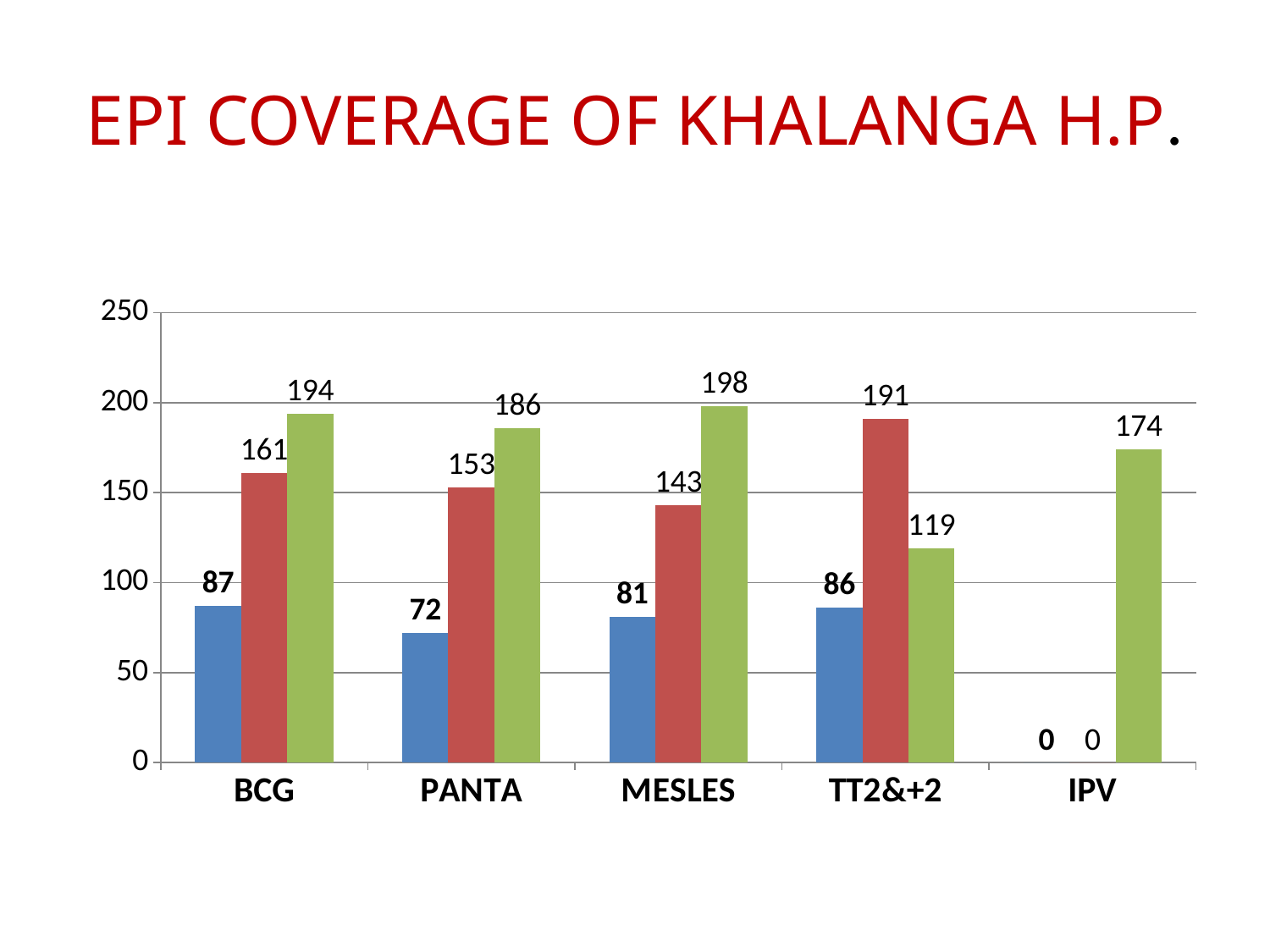
What is the difference between the blue bars for BCG and PANTA? 15 Which category has the lowest red bar? IPV What kind of chart is shown on the slide? bar chart What is the title of the slide? EPI COVERAGE OF KHALANGA H.P. Which is larger for TT2&+2, the red bar or the green bar? the red bar Which category has the highest green bar? MESLES What is the value of the red bar for TT2&+2? 191 What is the value of the green bar for IPV? 174 What is the value of the blue bar for PANTA? 72 What is the value of the blue bar for BCG? 87 How many categories are shown on the x axis? 5 What is the difference between the green bar and the red bar for BCG? 33